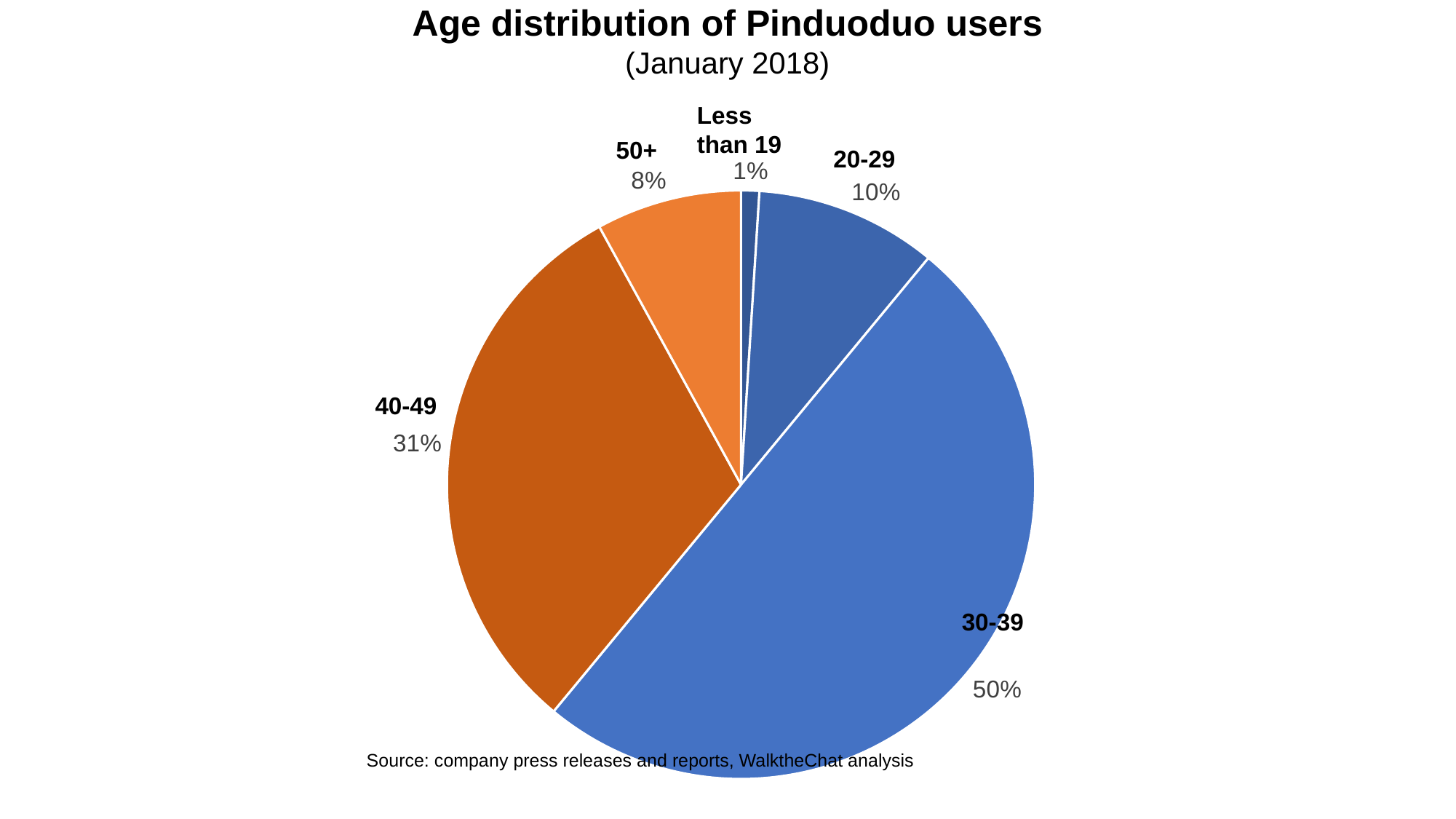
What share of Pinduoduo users are less than 19 years old? 1% What share of Pinduoduo users are aged 30-39? 50% What is the difference in share between the 30-39 and 40-49 age groups? 19% Which age group has a larger share, 20-29 or 50+? 20-29 What share of Pinduoduo users are aged 50+? 8% What kind of chart is shown on the slide? Pie chart How many age groups are shown in the pie chart? 5 Which age group has the smallest share of Pinduoduo users? Less than 19 What is the title of the chart? Age distribution of Pinduoduo users (January 2018) What share of Pinduoduo users are aged 20-29? 10% What share of Pinduoduo users are aged 40-49? 31% Which age group has the largest share of Pinduoduo users? 30-39